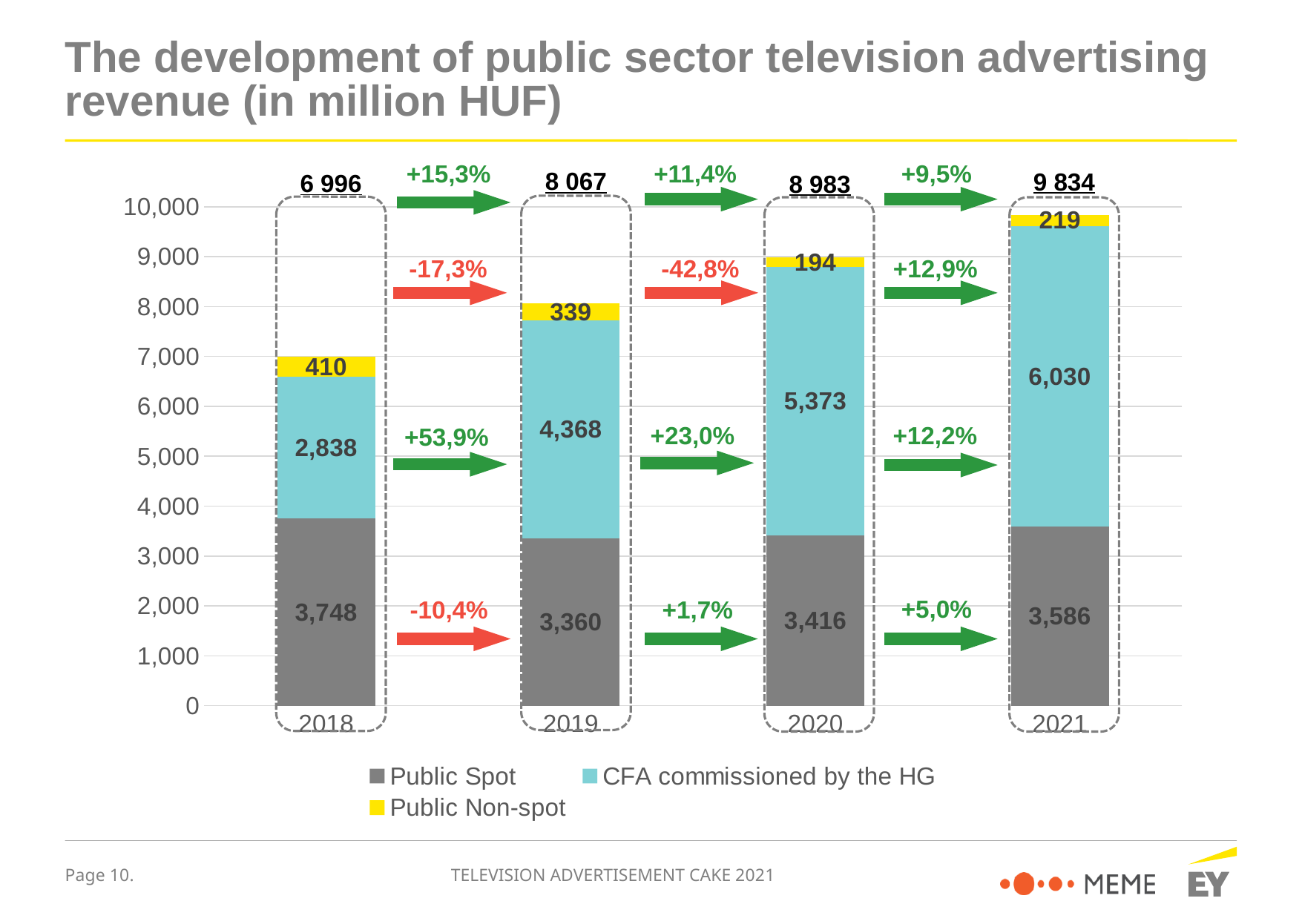
What is the difference between the Public Spot values for 2018 and 2019? 388 Do the total values rise or fall from 2018 to 2021? Rise Which year has the lowest Public Non-spot value? 2020 What is the total of the stacked bar for 2020? 8 983 What is the Public Non-spot value for 2019? 339 What kind of chart is shown on the slide? Stacked bar chart How many series does the legend list? 3 What is the Public Spot value for 2018? 3,748 How many years are shown on the x axis? 4 Which is larger, the CFA commissioned by the HG value for 2019 or for 2020? 2020 What is the CFA commissioned by the HG value for 2021? 6,030 Which year has the highest CFA commissioned by the HG value? 2021